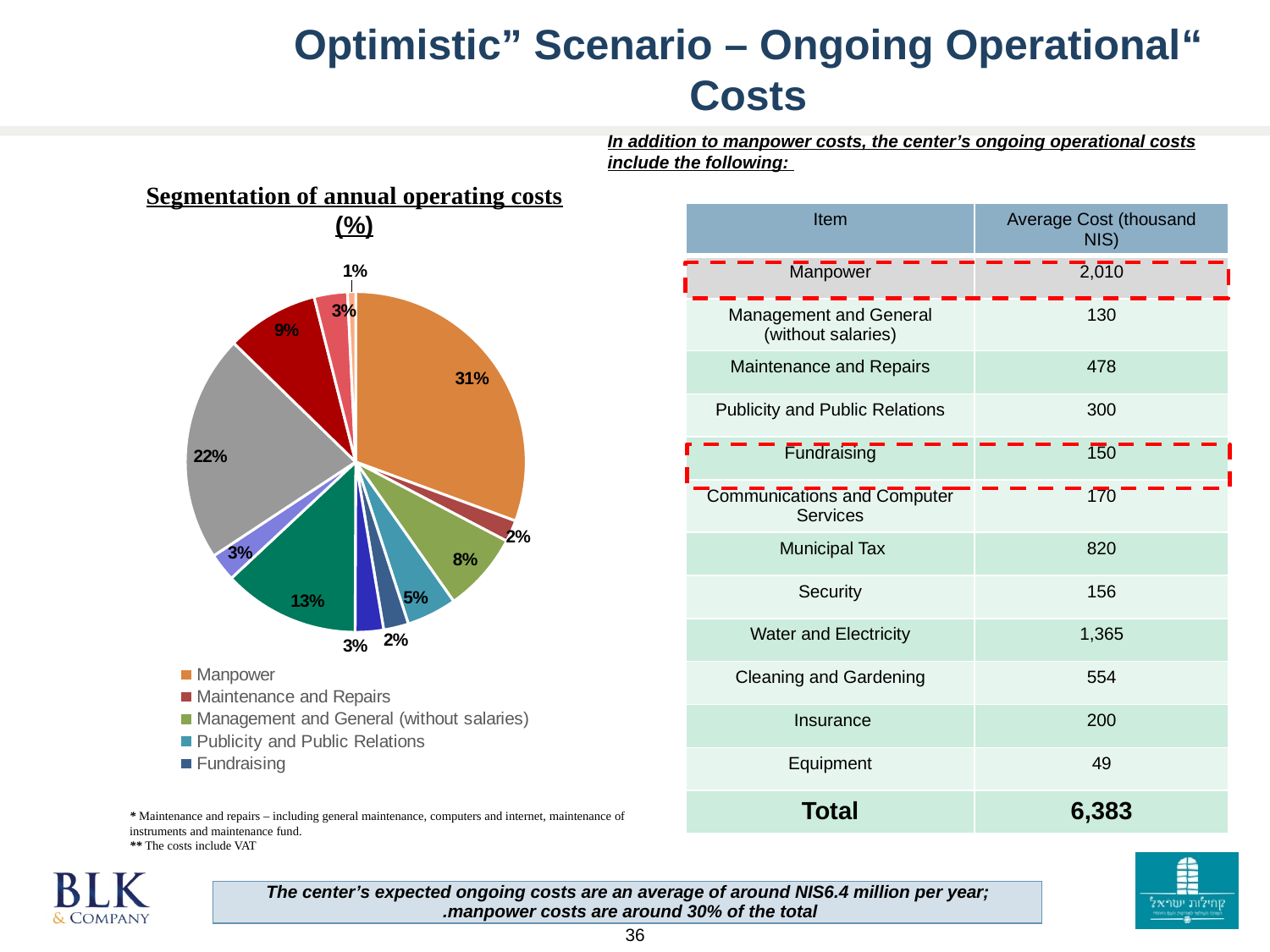
What is the difference in percentage points between the largest slice (31%) and the second-largest slice (22%) of the pie chart? 9 What is the smallest percentage labelled on any slice of the pie chart? 1% What kind of chart is shown on the left of the slide? Pie chart How many entries does the legend of the pie chart list? 5 Is the Manpower share in the pie chart greater or less than 30%? greater What is the title of the pie chart? Segmentation of annual operating costs (%) Which legend entry of the pie chart corresponds to the largest slice? Manpower How many slices does the pie chart have? 12 In the pie chart, what share is labelled on the Manpower slice? 31% What is the largest percentage labelled on any slice of the pie chart? 31% What colour represents Manpower in the pie chart legend? Orange In the pie chart, is the slice labelled 31% larger or smaller than the slice labelled 22%? Larger